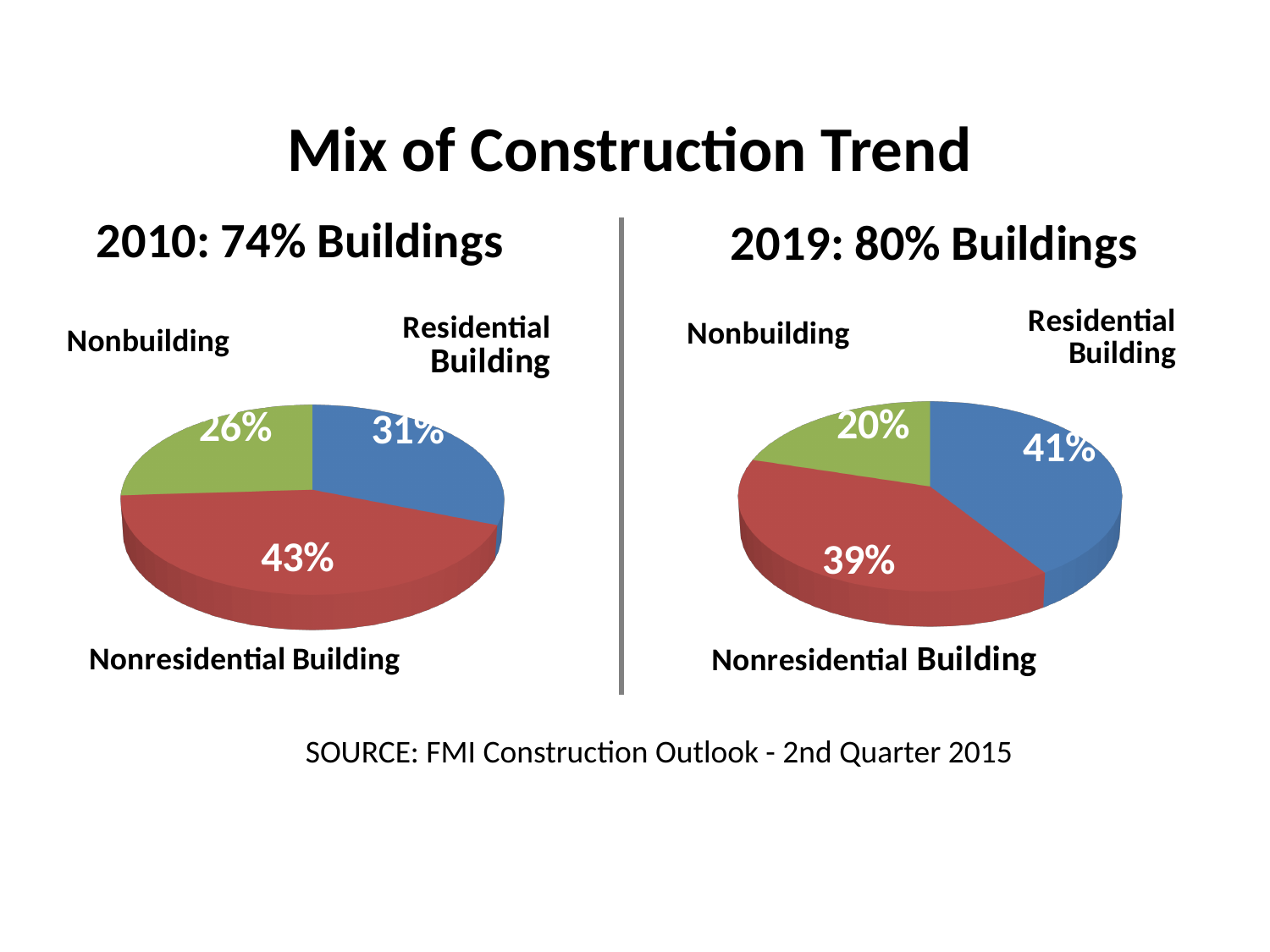
In the 2019 pie chart, which category has the largest share? Residential Building What is the title of the slide? Mix of Construction Trend In the 2019 pie chart, what share is Nonbuilding? 20% What type of chart is used on this slide? Pie chart In the 2010 pie chart, what is the difference between the Nonresidential Building and Residential Building shares? 12% In the 2010 pie chart, what share is Nonbuilding? 26% In the 2010 pie chart, which category has the largest share? Nonresidential Building How many categories does each pie chart show? 3 In the 2019 pie chart, is the share for Residential Building larger or smaller than the share for Nonresidential Building? larger In the 2010 pie chart, what share is Nonresidential Building? 43% In the 2019 pie chart, what share is Residential Building? 41% In the 2019 pie chart, which category has the smallest share? Nonbuilding